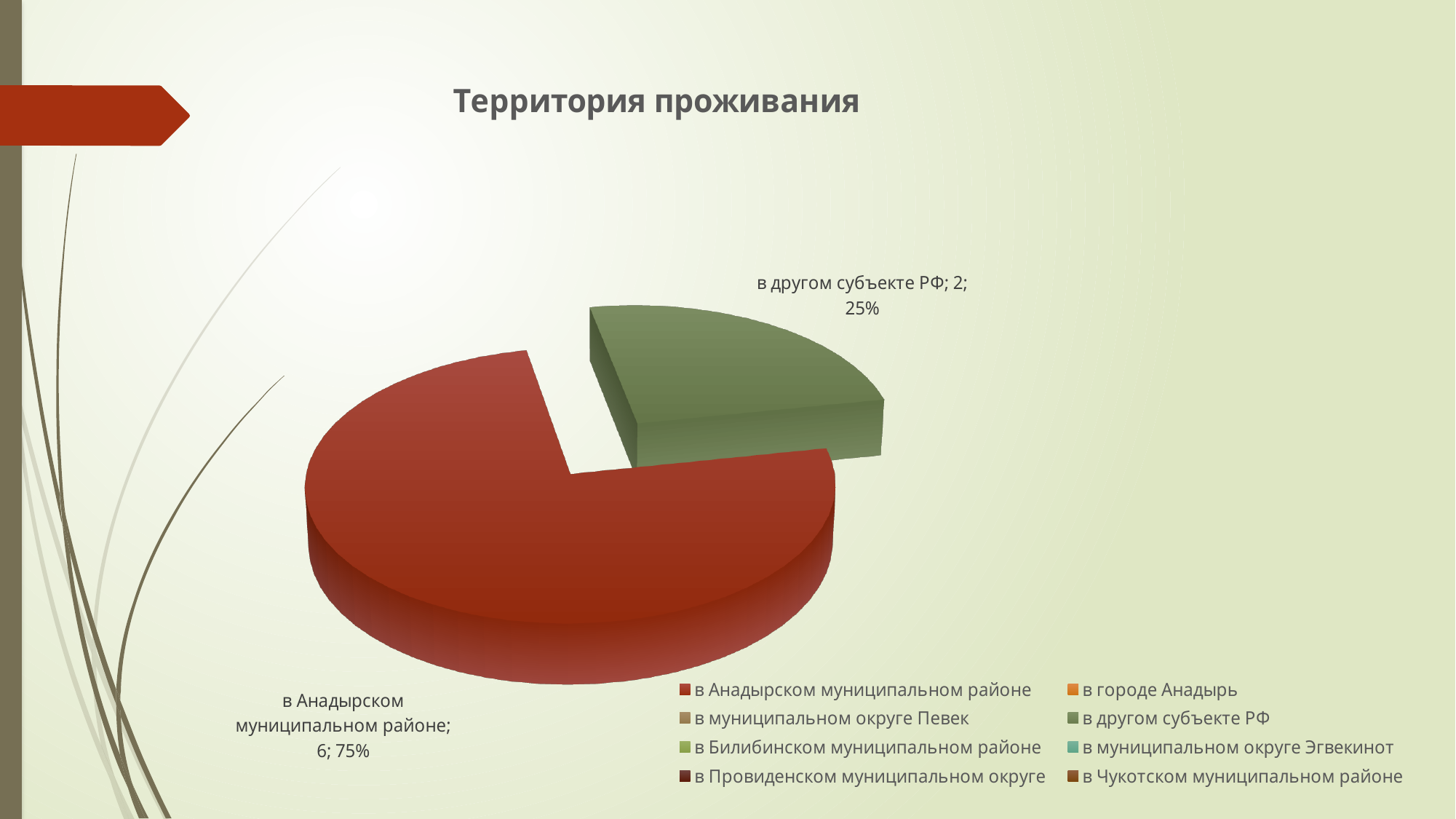
What share of the pie does "в Анадырском муниципальном районе" represent? 75% What is the value for "в другом субъекте РФ"? 2 How many slices with data labels are visible in the pie? 2 What is the difference between the values for "в Анадырском муниципальном районе" and "в другом субъекте РФ"? 4 Which is larger: the value for "в Анадырском муниципальном районе" or for "в другом субъекте РФ"? в Анадырском муниципальном районе What is the title of the chart? Территория проживания What kind of chart is shown on the slide? pie chart Which category has the largest slice of the pie? в Анадырском муниципальном районе What is the total of the two labelled slices in the pie? 8 What share of the pie does "в другом субъекте РФ" represent? 25% How many entries does the legend list? 8 What is the value for "в Анадырском муниципальном районе"? 6